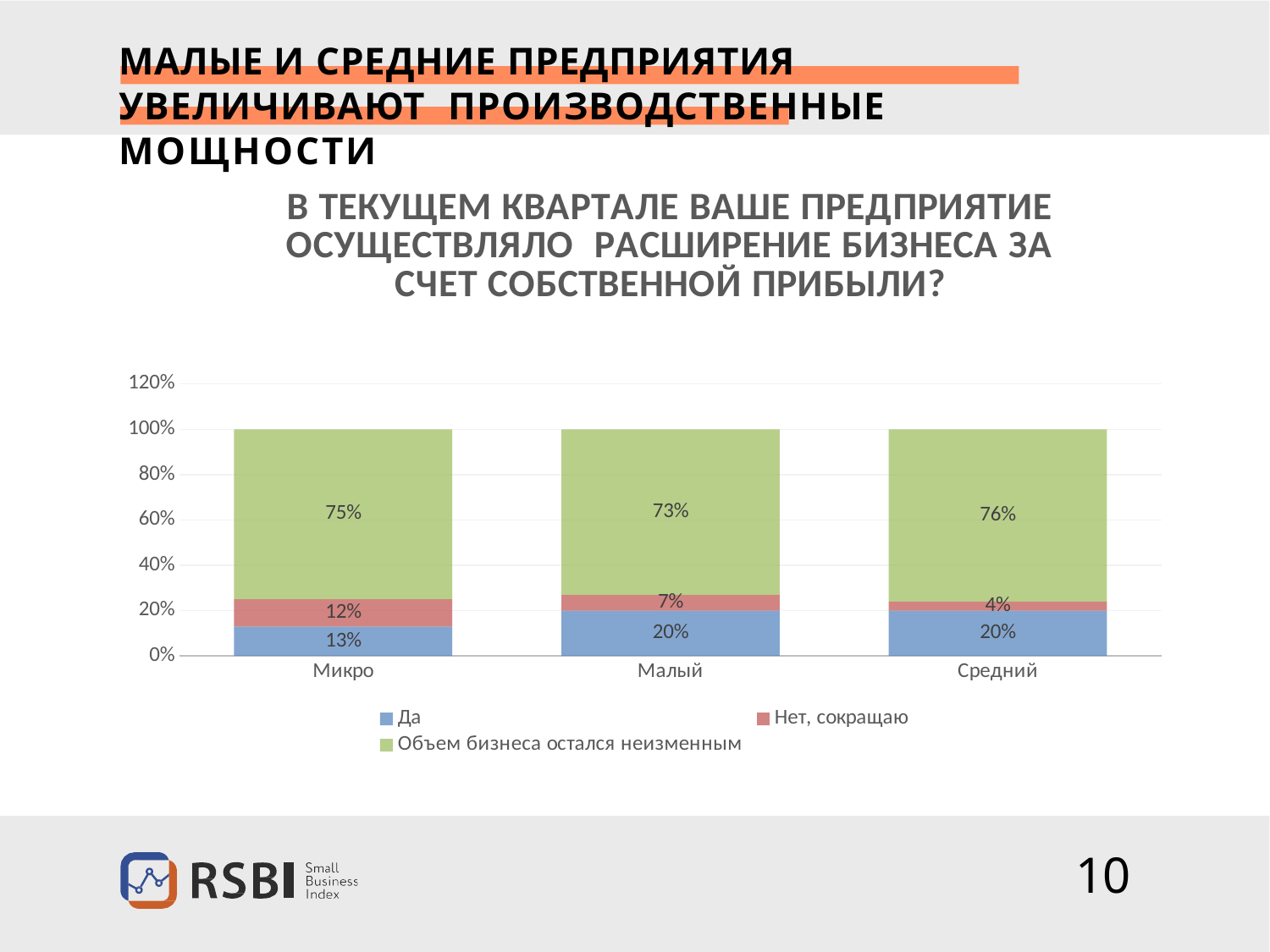
What is the value of "Объем бизнеса остался неизменным" for Средний? 76% How many categories are shown on the x axis? 3 What is the value of "Нет, сокращаю" for Малый? 7% Which category has the lowest value for "Да"? Микро What is the difference between the "Объем бизнеса остался неизменным" values for Средний and Малый? 3% How many series does the legend list? 3 Which category has the highest value for "Нет, сокращаю"? Микро What is the value of "Нет, сокращаю" for Средний? 4% What is the value of "Да" for Микро? 13% What is the total of the stacked bar for Малый? 100% What kind of chart is shown on the slide? Stacked bar chart Which is larger: the "Нет, сокращаю" value for Микро or for Средний? Микро